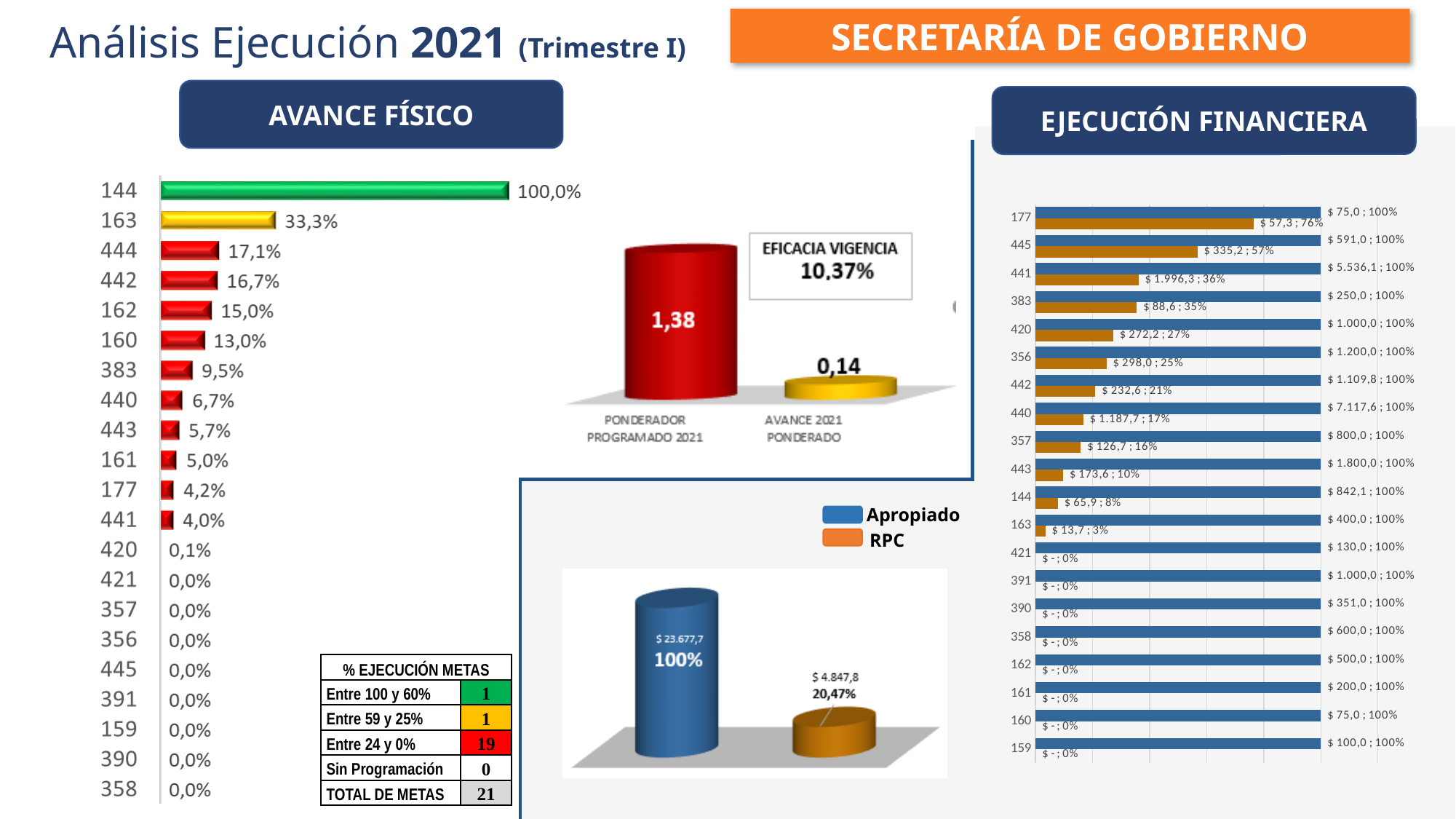
In the EJECUCIÓN FINANCIERA chart, what is the Apropiado label for category 440? $ 7.117,6 ; 100% In the EFICACIA VIGENCIA chart, what is the value for PONDERADOR PROGRAMADO 2021? 1,38 In the AVANCE FÍSICO chart, which category has the highest value? 144 In the Apropiado/RPC chart at the bottom centre, how many series does the legend list? 2 In the AVANCE FÍSICO chart, what is the value for category 163? 33,3% In the EJECUCIÓN FINANCIERA chart, what is the RPC label for category 441? $ 1.996,3 ; 36% In the AVANCE FÍSICO chart, which is larger, the value for 383 or the value for 440? 383 In the AVANCE FÍSICO chart, what is the difference between the values for 444 and 442? 0,4% In the AVANCE FÍSICO chart, how many categories are plotted? 21 In the Apropiado/RPC chart at the bottom centre, what amount is shown for RPC? $ 4.847,8 What kind of chart is the EJECUCIÓN FINANCIERA chart? Bar chart In the EFICACIA VIGENCIA chart, what is the value for AVANCE 2021 PONDERADO? 0,14